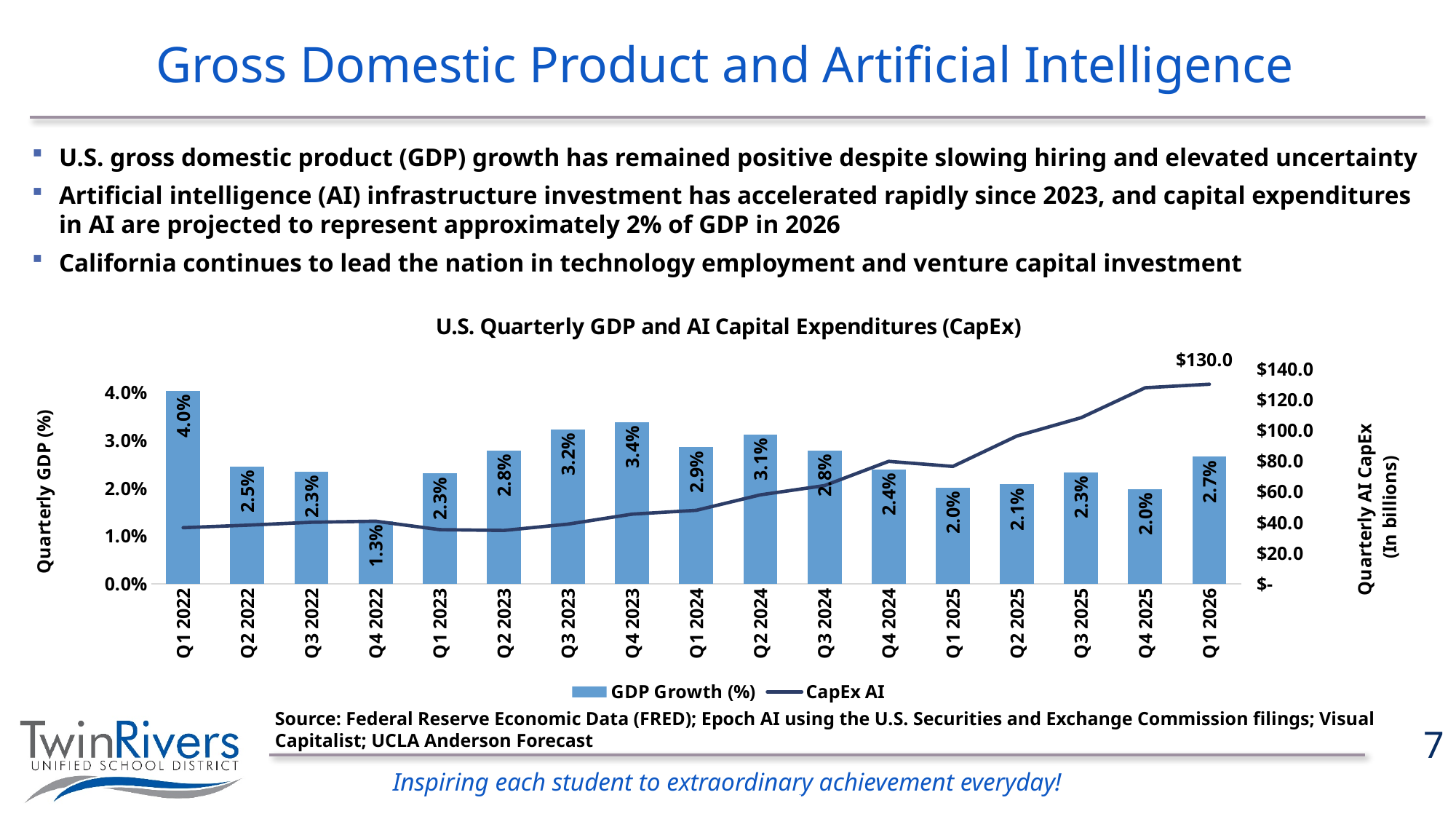
What is the difference in GDP Growth (%) between Q1 2022 and Q4 2022? 2.7% How many series does the chart legend list? 2 Which quarter has the highest GDP Growth (%)? Q1 2022 How many quarters are shown on the x axis of the chart? 17 What is the CapEx AI value labeled at Q1 2026? $130.0 Which quarter has the lowest GDP Growth (%)? Q4 2022 Does the CapEx AI line generally rise or fall from Q1 2022 to Q1 2026? rise Is the CapEx AI value for Q4 2025 greater or less than $100.0? greater What is the GDP Growth (%) value for Q4 2023? 3.4% Is the CapEx AI value for Q1 2022 greater or less than $60.0? less What is the GDP Growth (%) value for Q1 2026? 2.7% Which has the larger GDP Growth (%), Q3 2023 or Q2 2024? Q3 2023